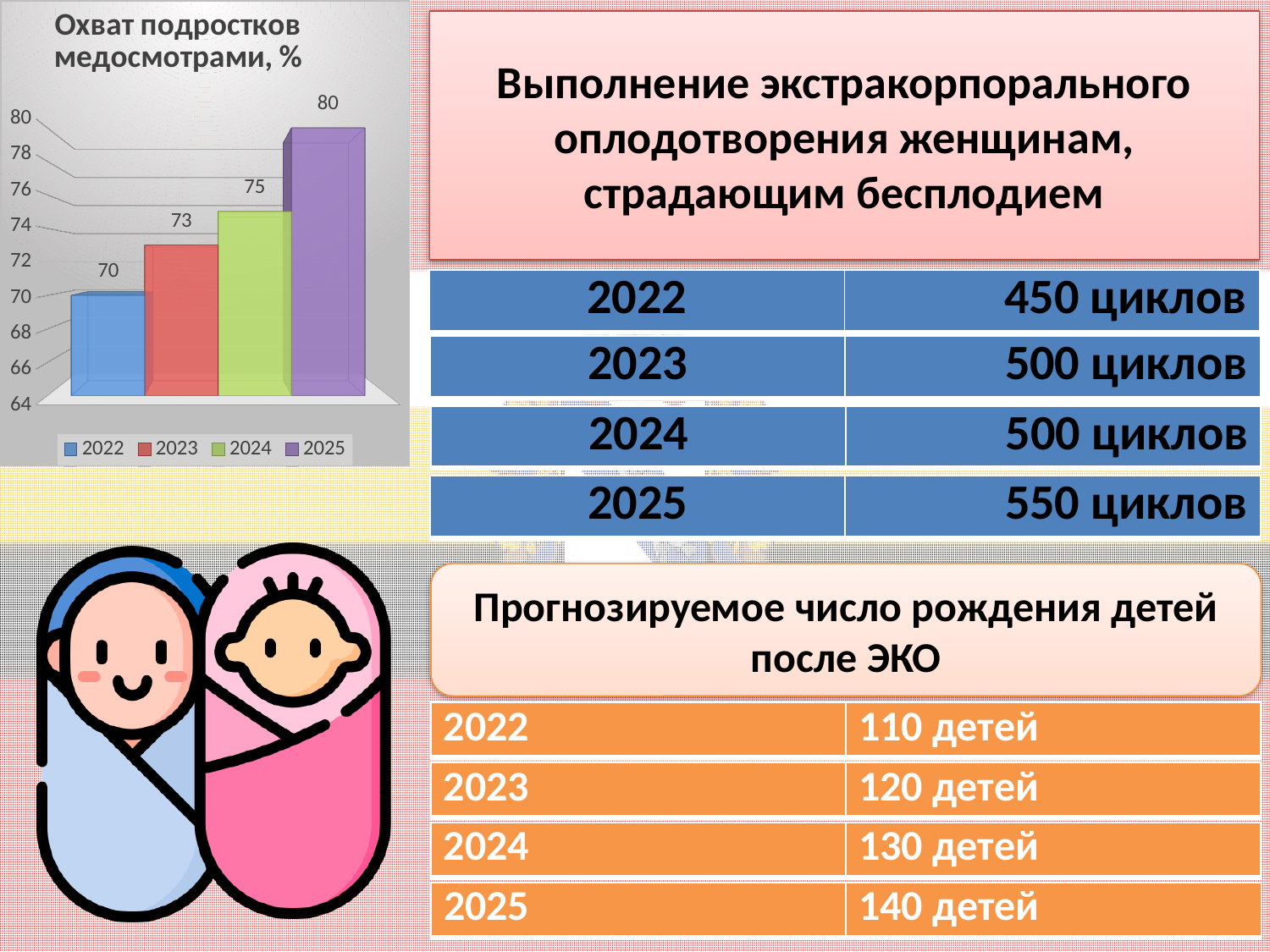
Which year has the highest value in the chart "Охват подростков медосмотрами, %"? 2025 In the chart "Охват подростков медосмотрами, %", what is the difference between the values for 2025 and 2022? 10 What is the value for 2025 in the chart "Охват подростков медосмотрами, %"? 80 What is the value for 2024 in the chart "Охват подростков медосмотрами, %"? 75 In the chart "Охват подростков медосмотрами, %", which is larger: the value for 2023 or the value for 2024? 2024 Do the values in the chart "Охват подростков медосмотрами, %" rise or fall from 2022 to 2025? rise How many entries does the legend of the chart "Охват подростков медосмотрами, %" list? 4 Which year has the lowest value in the chart "Охват подростков медосмотрами, %"? 2022 What is the value for 2022 in the chart "Охват подростков медосмотрами, %"? 70 What is the value for 2023 in the chart "Охват подростков медосмотрами, %"? 73 How many bars are plotted in the chart "Охват подростков медосмотрами, %"? 4 What kind of chart is "Охват подростков медосмотрами, %"? bar chart